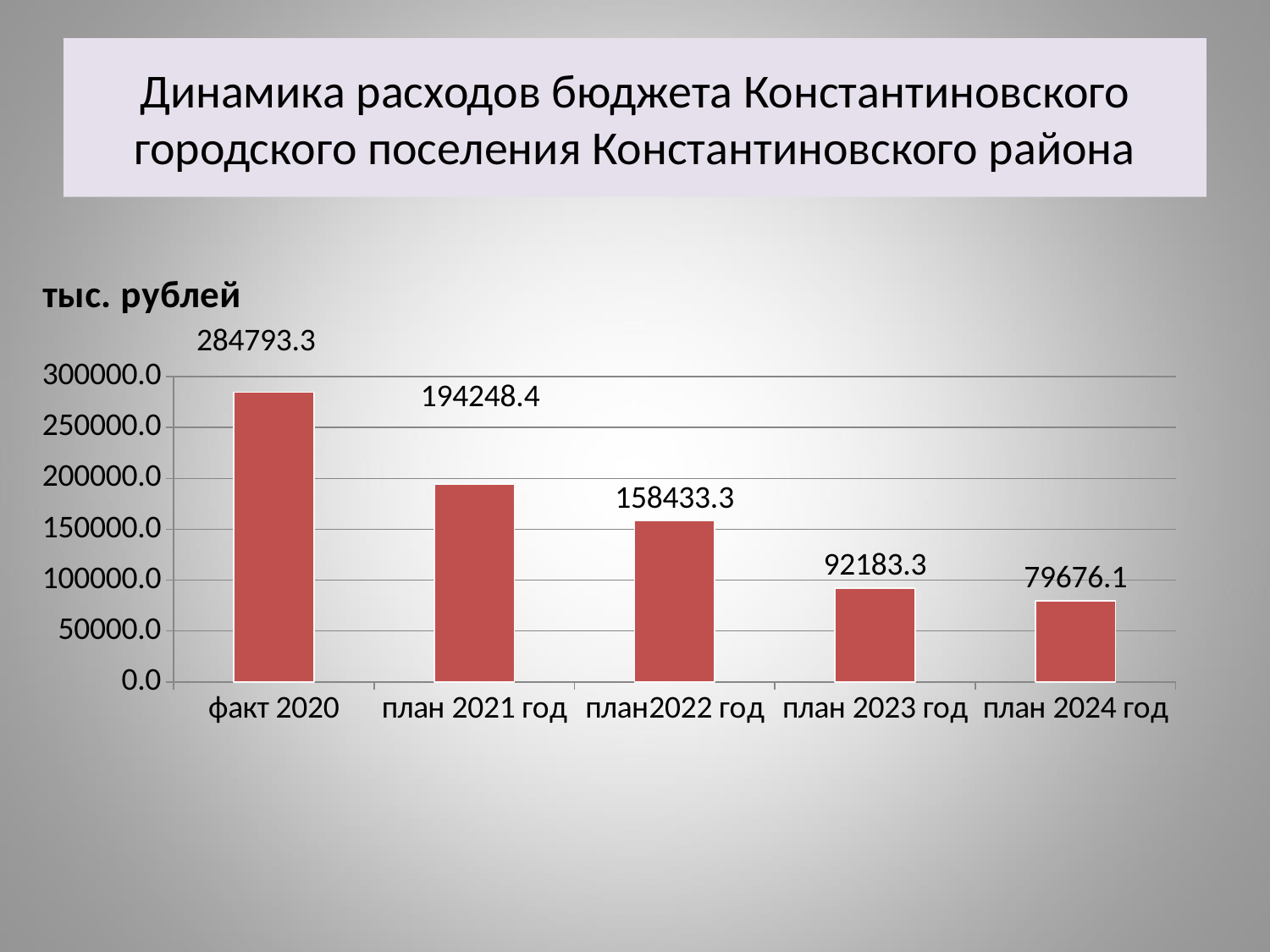
What kind of chart is shown on the slide? bar chart Which is larger, the value for план 2021 год or the value for план2022 год? план 2021 год What is the value for план 2023 год? 92183.3 Which category has the highest value? факт 2020 Is the value for план2022 год greater or less than 150000.0? greater What is the value for план 2024 год? 79676.1 What is the value for факт 2020? 284793.3 What is the difference between the values for факт 2020 and план 2021 год? 90544.9 Do the values rise or fall from факт 2020 to план 2024 год? fall Which category has the lowest value? план 2024 год What is the difference between the values for план 2023 год and план 2024 год? 12507.2 How many categories are shown on the x axis? 5